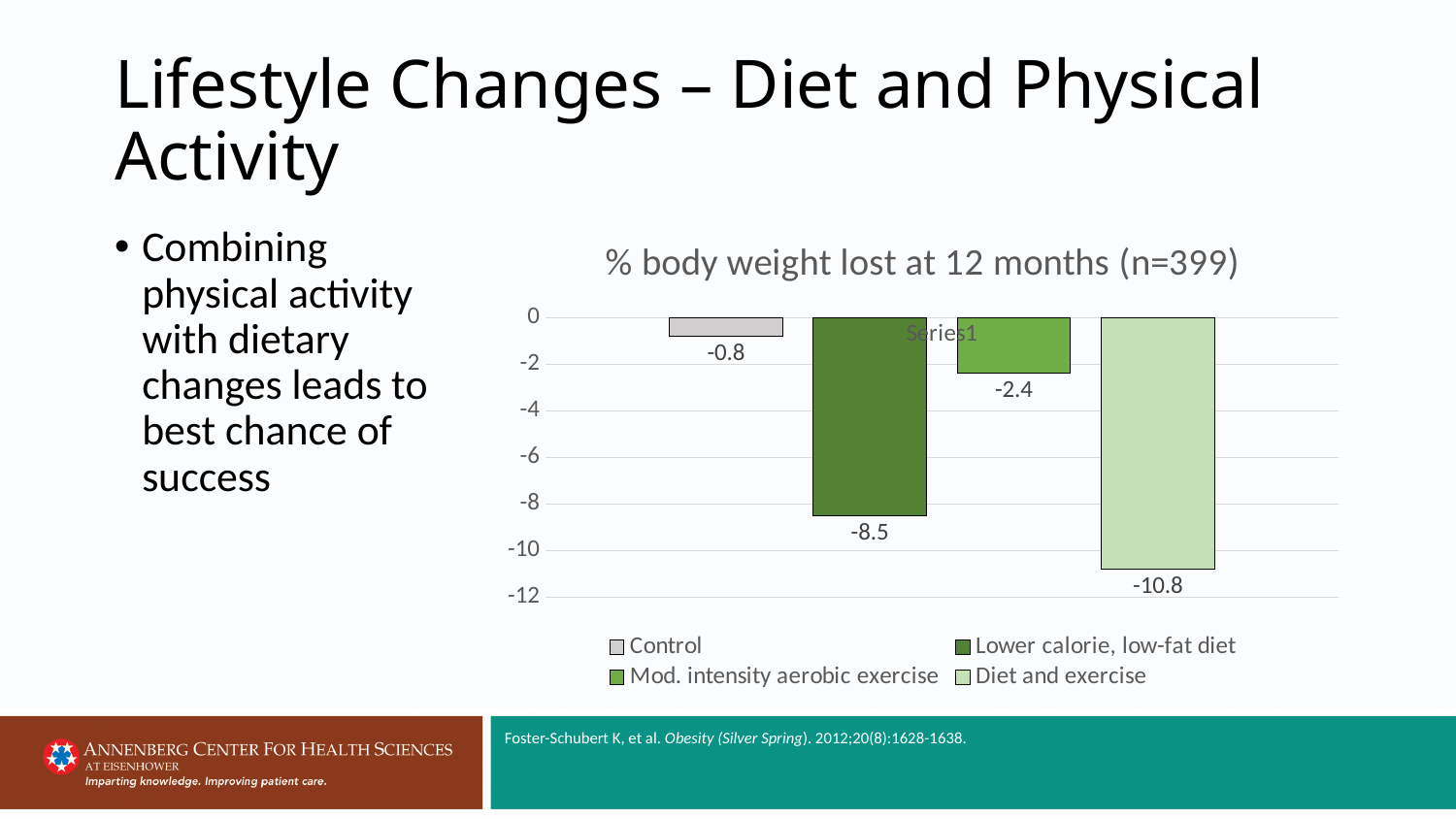
Which has a larger % body weight lost: Lower calorie, low-fat diet or Mod. intensity aerobic exercise? Lower calorie, low-fat diet What is the value for Mod. intensity aerobic exercise in the chart? -2.4 What is the value for Lower calorie, low-fat diet in the chart? -8.5 What is the value for Diet and exercise in the chart? -10.8 What is the value for Control in the chart? -0.8 What is the title of the chart? % body weight lost at 12 months (n=399) Which group has the lowest value (greatest % body weight lost) in the chart? Diet and exercise How many bars are plotted in the chart? 4 How many entries does the chart legend list? 4 What is the difference between the values for Diet and exercise and Lower calorie, low-fat diet? 2.3 Which group has the highest value (smallest % body weight lost) in the chart? Control What is the difference between the values for Mod. intensity aerobic exercise and Control? 1.6